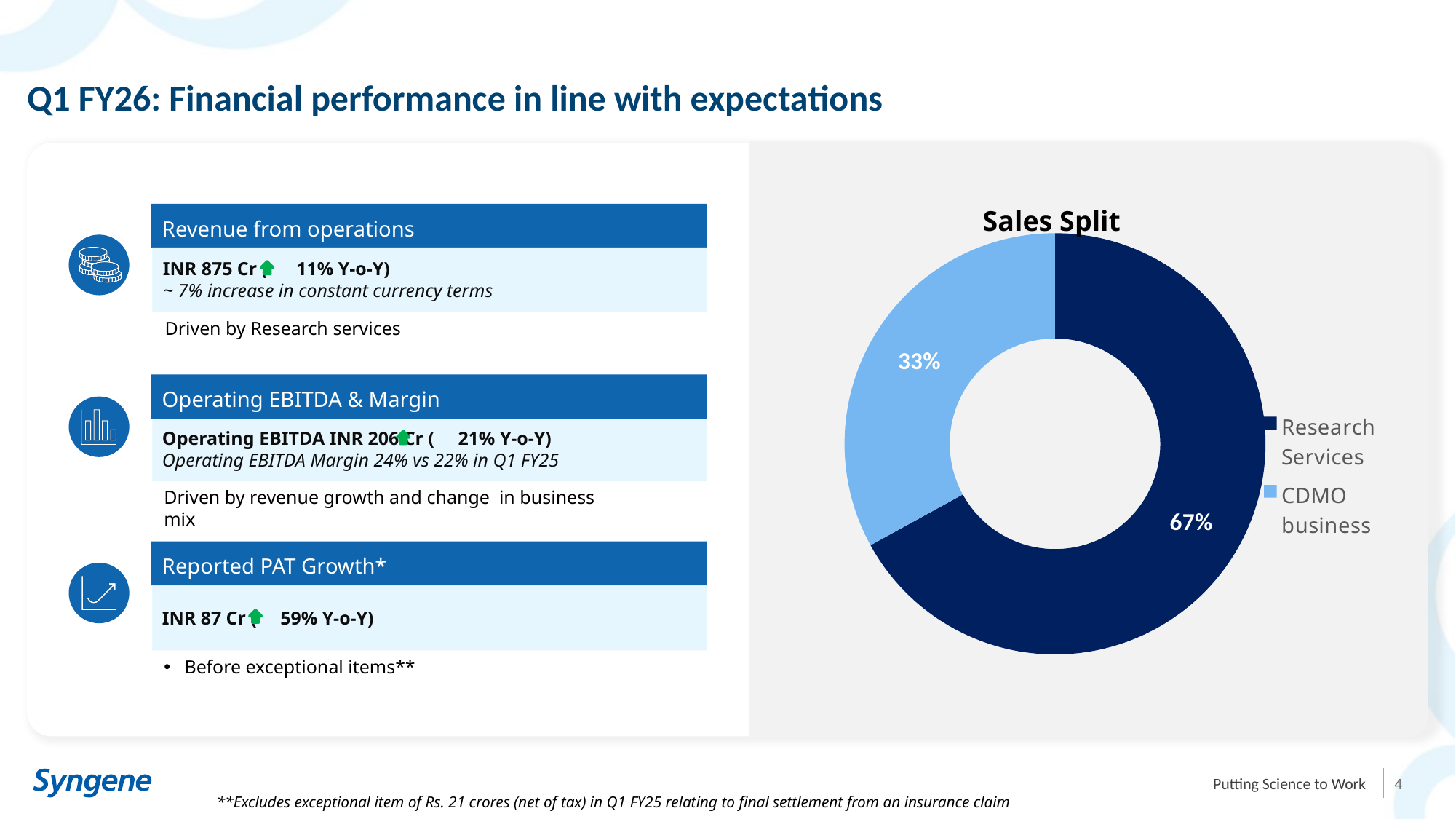
Is the share for CDMO business in the Sales Split chart greater or less than 50%? less Which segment has the smallest share in the Sales Split chart? CDMO business How many entries does the legend of the Sales Split chart list? 2 What share of the Sales Split does CDMO business account for? 33% How many segments are shown in the Sales Split chart? 2 What kind of chart is the Sales Split chart? Doughnut (pie) chart In the Sales Split chart, which is larger: Research Services or CDMO business? Research Services Which segment has the largest share in the Sales Split chart? Research Services What is the difference in percentage points between the Research Services and CDMO business shares in the Sales Split chart? 34 What share of the Sales Split does Research Services account for? 67% In the Sales Split chart, which segment is shown in dark navy blue? Research Services What is the title of the chart on the slide? Sales Split